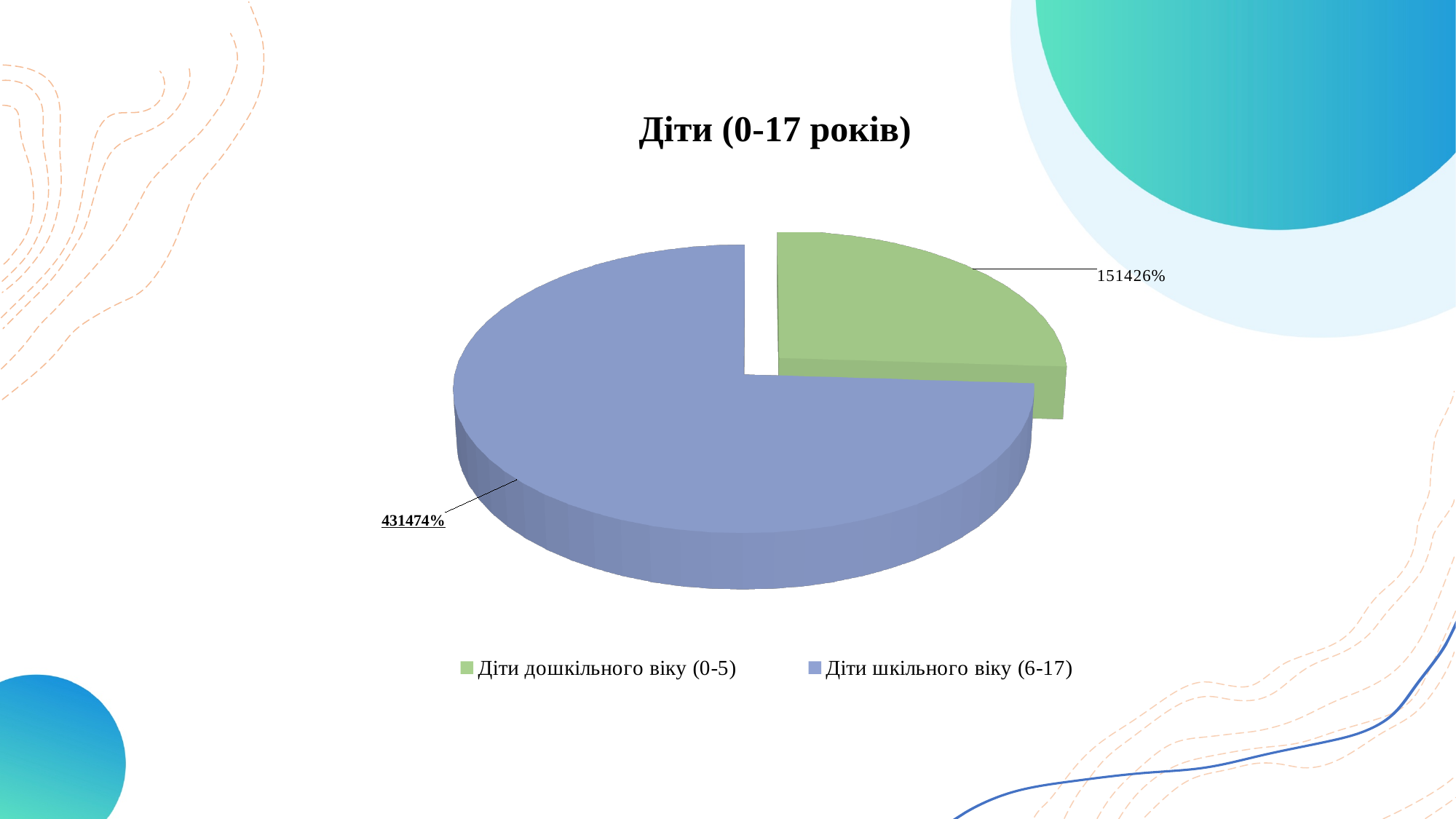
How many slices does the pie chart have? 2 Which category has the largest slice of the pie? Діти шкільного віку (6-17) Which is larger: the value for Діти дошкільного віку (0-5) or for Діти шкільного віку (6-17)? Діти шкільного віку (6-17) How many entries does the legend list? 2 What kind of chart is shown on the slide? pie chart What colour is the slice for Діти дошкільного віку (0-5)? green What value is shown for Діти дошкільного віку (0-5)? 151426% What is the title of the chart? Діти (0-17 років) What value is shown for Діти шкільного віку (6-17)? 431474% Which category has the smallest slice of the pie? Діти дошкільного віку (0-5)